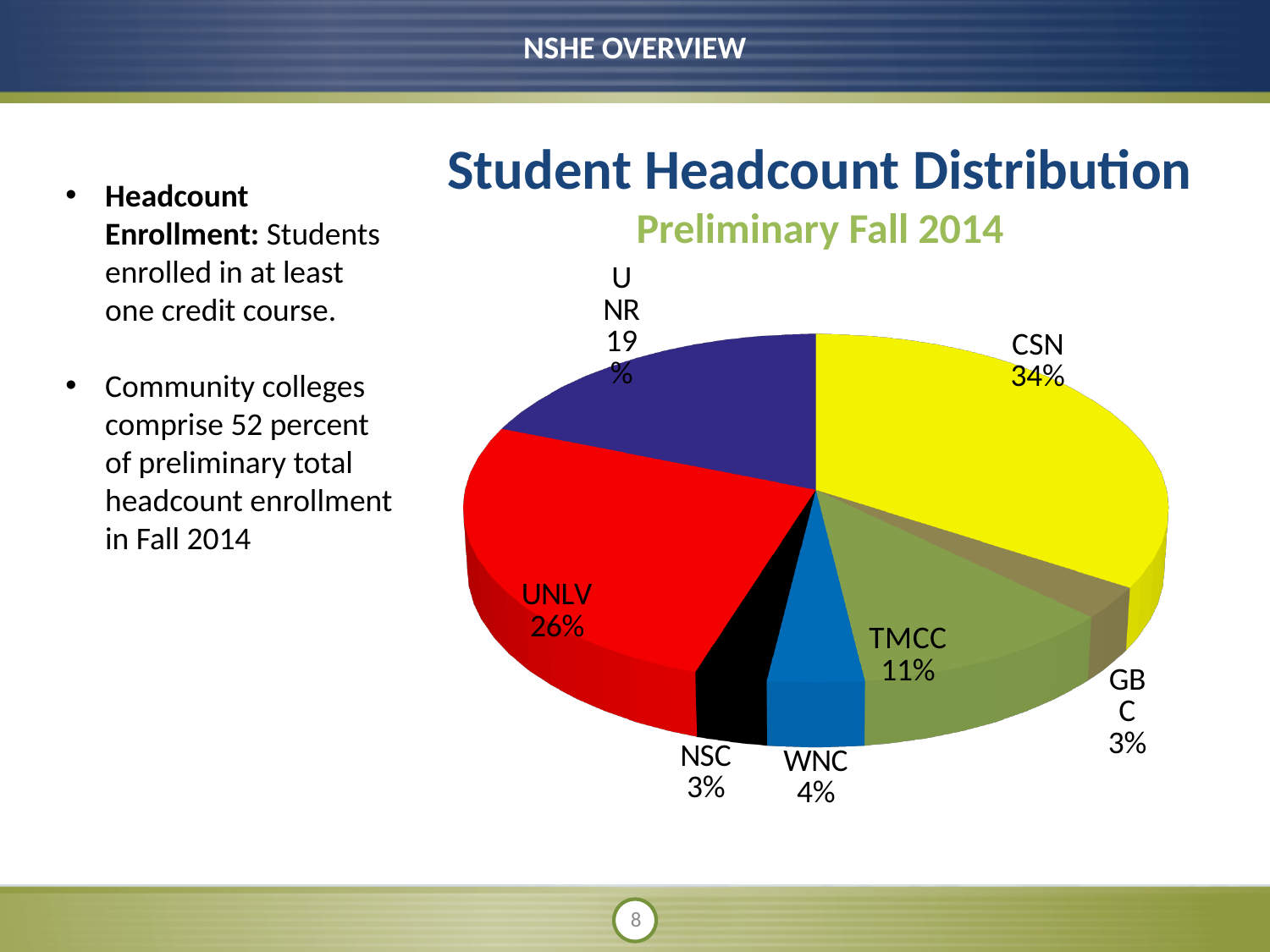
How many slices does the pie chart have? 7 What is the title of the chart? Student Headcount Distribution Preliminary Fall 2014 What colour is the UNLV slice? Red What is the difference in percentage points between CSN and UNLV? 8 What kind of chart is shown on the slide? Pie chart Which institution has the largest slice of the pie? CSN What share of the pie does UNR hold? 19% Which is larger, the share for UNR or the share for TMCC? UNR What share of the pie does TMCC hold? 11% What share of the pie does UNLV hold? 26%